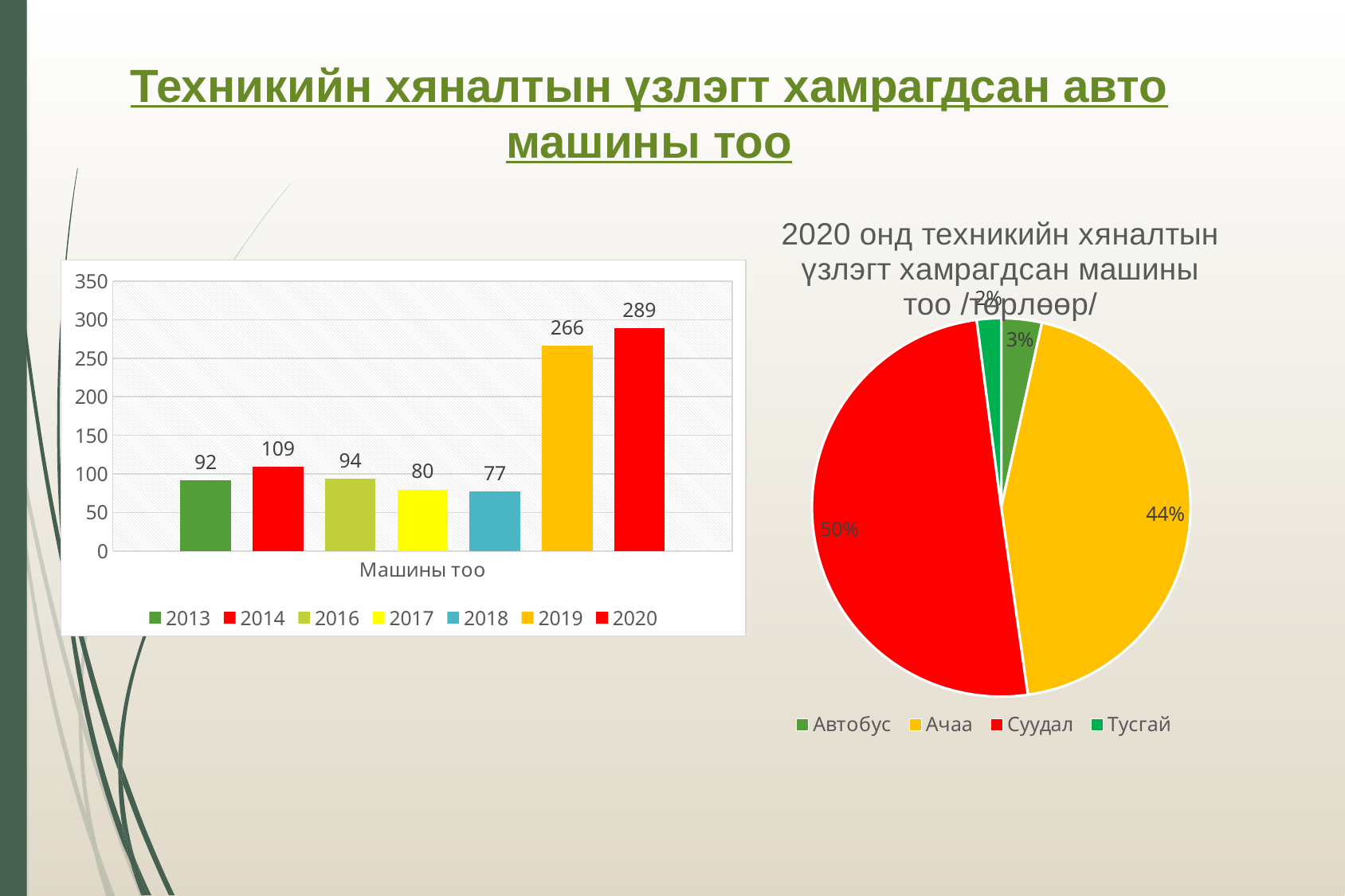
What kind of chart is the chart on the left of the slide? bar chart In the bar chart on the left, how many series does the legend list? 7 In the pie chart on the right, what share does Суудал have? 50% In the pie chart on the right, how many categories does the legend list? 4 In the pie chart on the right, which category has the smallest slice? Тусгай In the bar chart on the left, which is larger, the value for 2014 or the value for 2016? 2014 In the pie chart on the right, what share does Ачаа have? 44% In the bar chart on the left, what is the value for 2019? 266 In the bar chart on the left, what is the value for 2017? 80 In the bar chart on the left, which year has the lowest value? 2018 In the bar chart on the left, which year has the highest value? 2020 In the bar chart on the left, what is the difference between the values for 2020 and 2019? 23